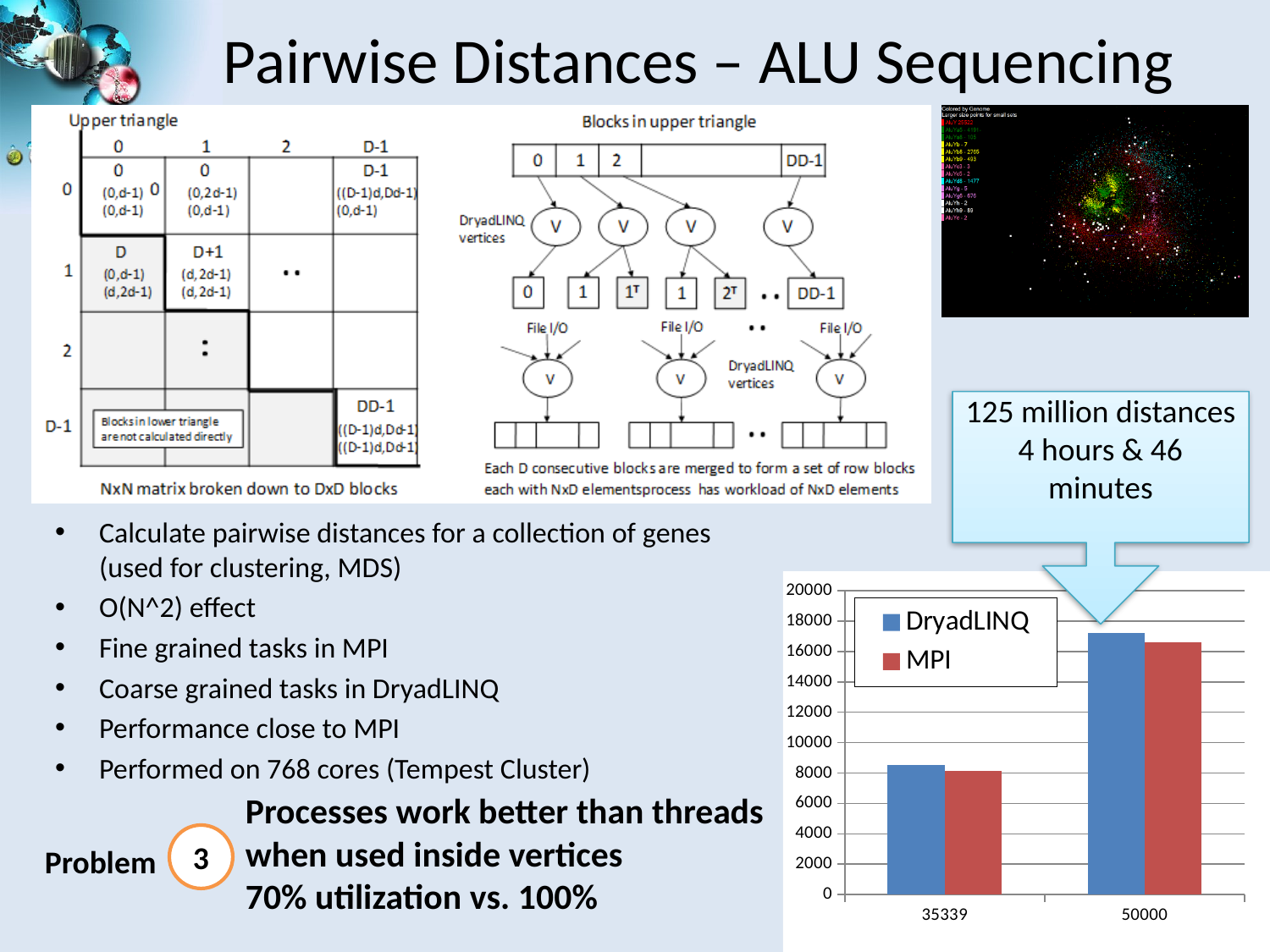
Which series are listed in the legend of the bar chart? DryadLINQ and MPI How many categories are shown on the x axis of the bar chart? 2 What kind of chart is shown at the bottom right of the slide? bar chart In the bar chart, which category has the higher DryadLINQ value, 35339 or 50000? 50000 In the bar chart, is the DryadLINQ value for 50000 greater or less than 16000? greater In the bar chart, for the 50000 category, which series has the larger value, DryadLINQ or MPI? DryadLINQ In the bar chart, do the MPI values rise or fall from 35339 to 50000? rise In the bar chart, is the DryadLINQ value for 35339 greater or less than 10000? less In the bar chart, is the MPI value for 50000 greater or less than 14000? greater How many series does the legend of the bar chart list? 2 What are the two categories on the x axis of the bar chart? 35339 and 50000